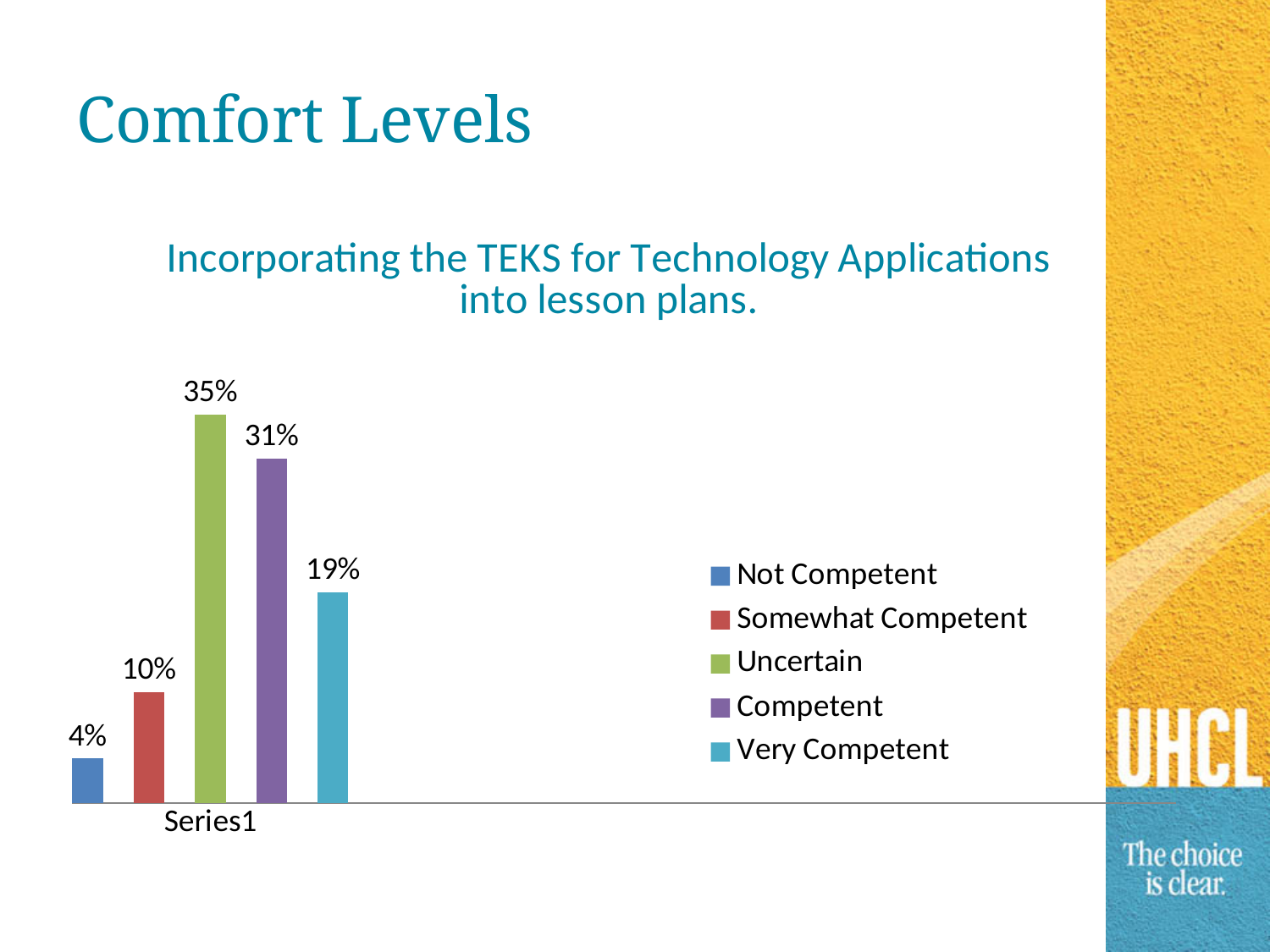
How many series does the legend list? 5 What is the difference between the Uncertain and Competent values? 4% Which comfort level has the highest value? Uncertain What is the value for Somewhat Competent? 10% Which is larger, the value for Competent or the value for Very Competent? Competent What is the difference between the Very Competent and Not Competent values? 15% What is the value for Very Competent? 19% What is the value for Not Competent? 4% What kind of chart is shown on the slide? Bar chart What percentage of respondents reported being Uncertain? 35% What colour is the bar for Uncertain? Green Which comfort level has the lowest value? Not Competent